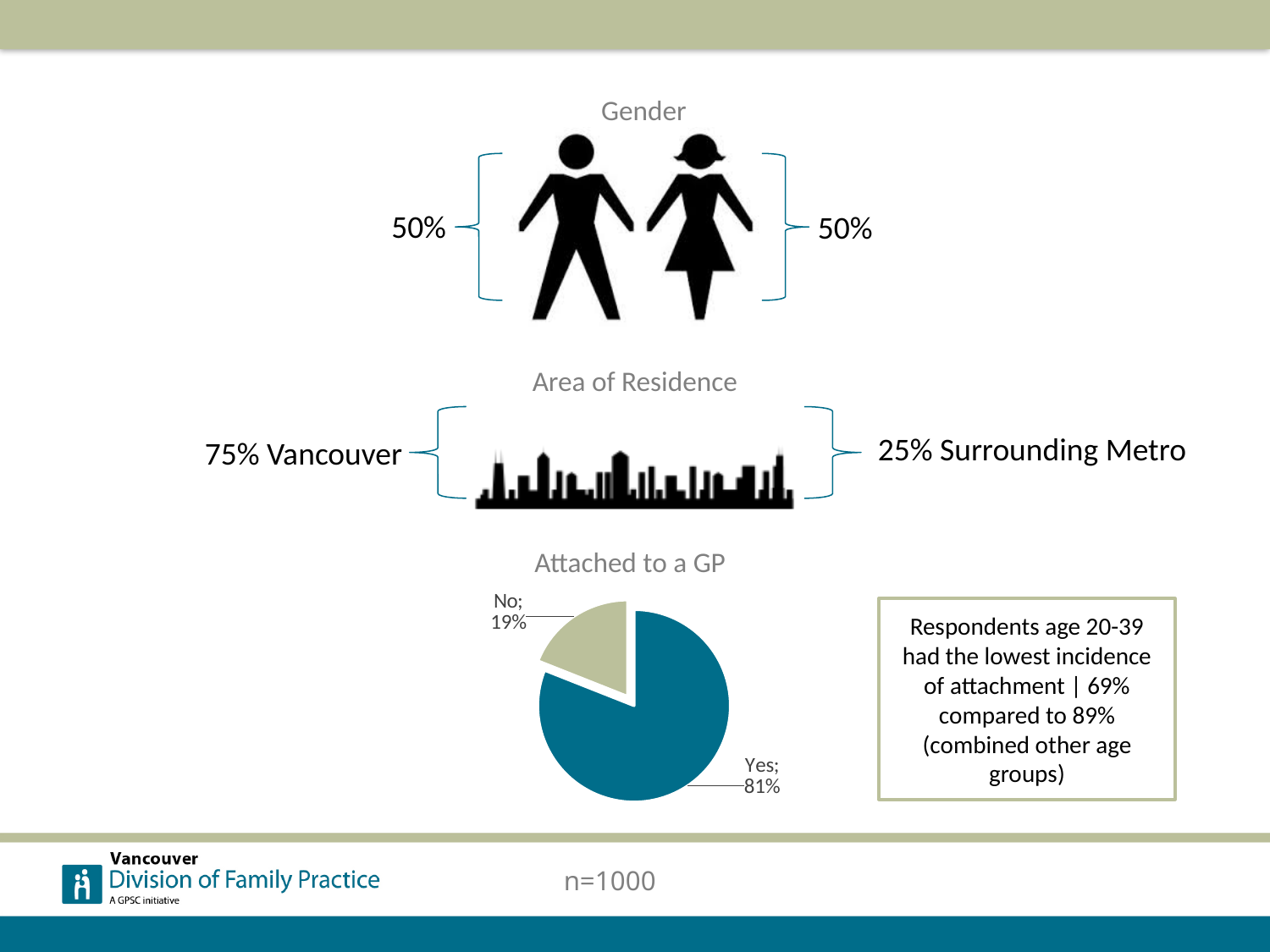
In the "Attached to a GP" pie chart, what is the difference in percentage points between the Yes and No slices? 62 percentage points In the "Attached to a GP" pie chart, which is larger, the Yes slice or the No slice? Yes What kind of chart is used to show "Attached to a GP"? Pie chart In the "Attached to a GP" pie chart, which slice is the smallest? No In the "Attached to a GP" pie chart, what share of the pie does the Yes slice represent? 81% In the "Attached to a GP" pie chart, what do the Yes and No slices add up to? 100% In the "Attached to a GP" pie chart, what colour is the Yes slice? Teal blue In the "Attached to a GP" pie chart, what percentage of respondents answered No? 19% What is the title of the pie chart on the slide? Attached to a GP In the "Attached to a GP" pie chart, what percentage of respondents answered Yes? 81% In the "Attached to a GP" pie chart, which slice is the largest? Yes How many slices does the "Attached to a GP" pie chart have? 2